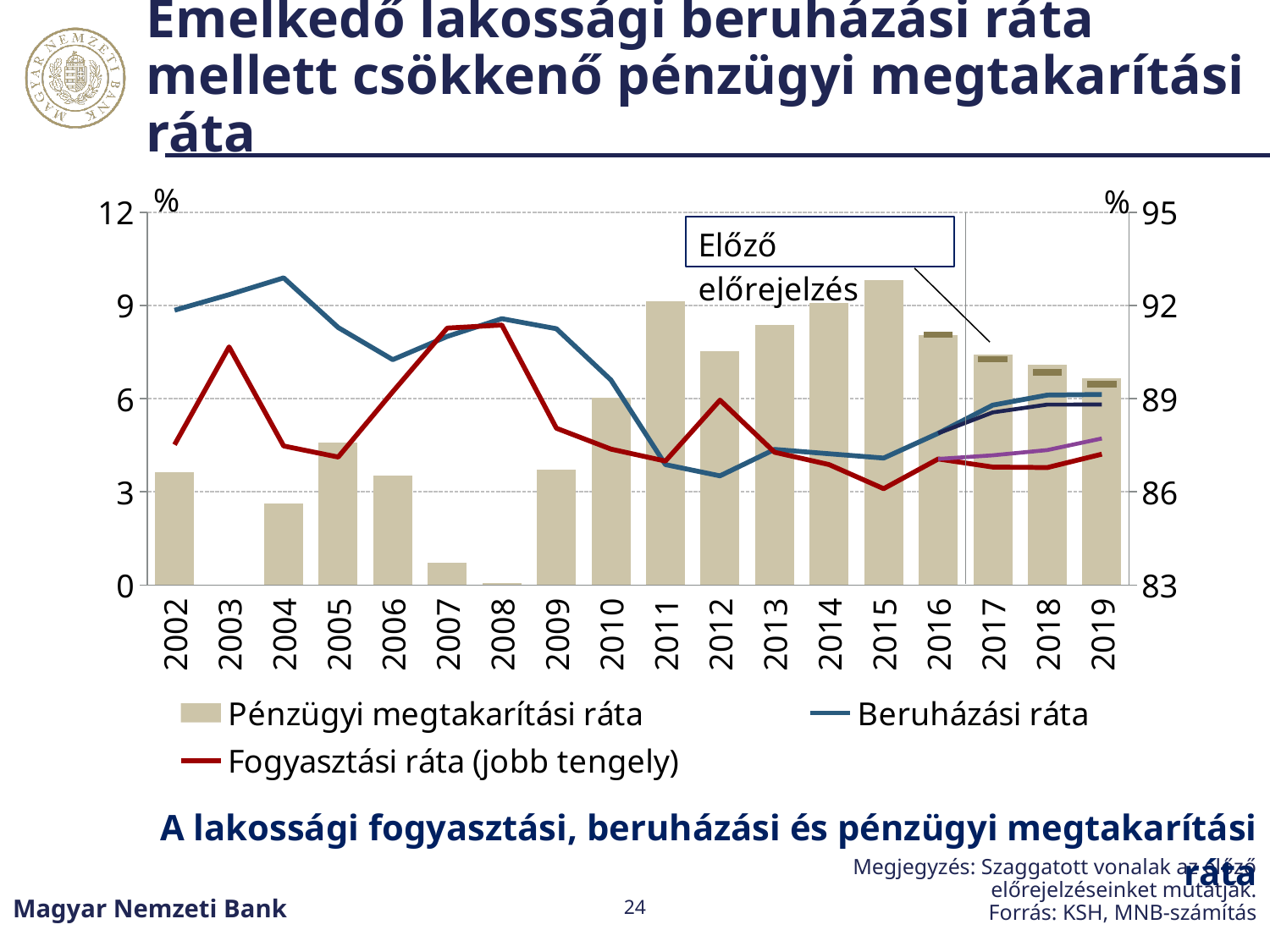
Is the Beruházási ráta value for 2004 greater or less than 9? greater Is the Pénzügyi megtakarítási ráta bar for 2007 greater or less than 3? less Do the Pénzügyi megtakarítási ráta bars rise or fall from 2016 to 2019? fall How many years are shown on the x axis of the chart? 18 Is the Pénzügyi megtakarítási ráta bar for 2015 greater or less than 9? greater In which year is the Pénzügyi megtakarítási ráta bar the highest? 2015 Which is larger, the Beruházási ráta in 2004 or in 2012? 2004 Which series is plotted on the right axis according to the legend? Fogyasztási ráta (jobb tengely) What kind of chart is shown on the slide? A combined bar and line chart How many series does the chart legend list? 3 In which year is the Pénzügyi megtakarítási ráta bar the lowest? 2003